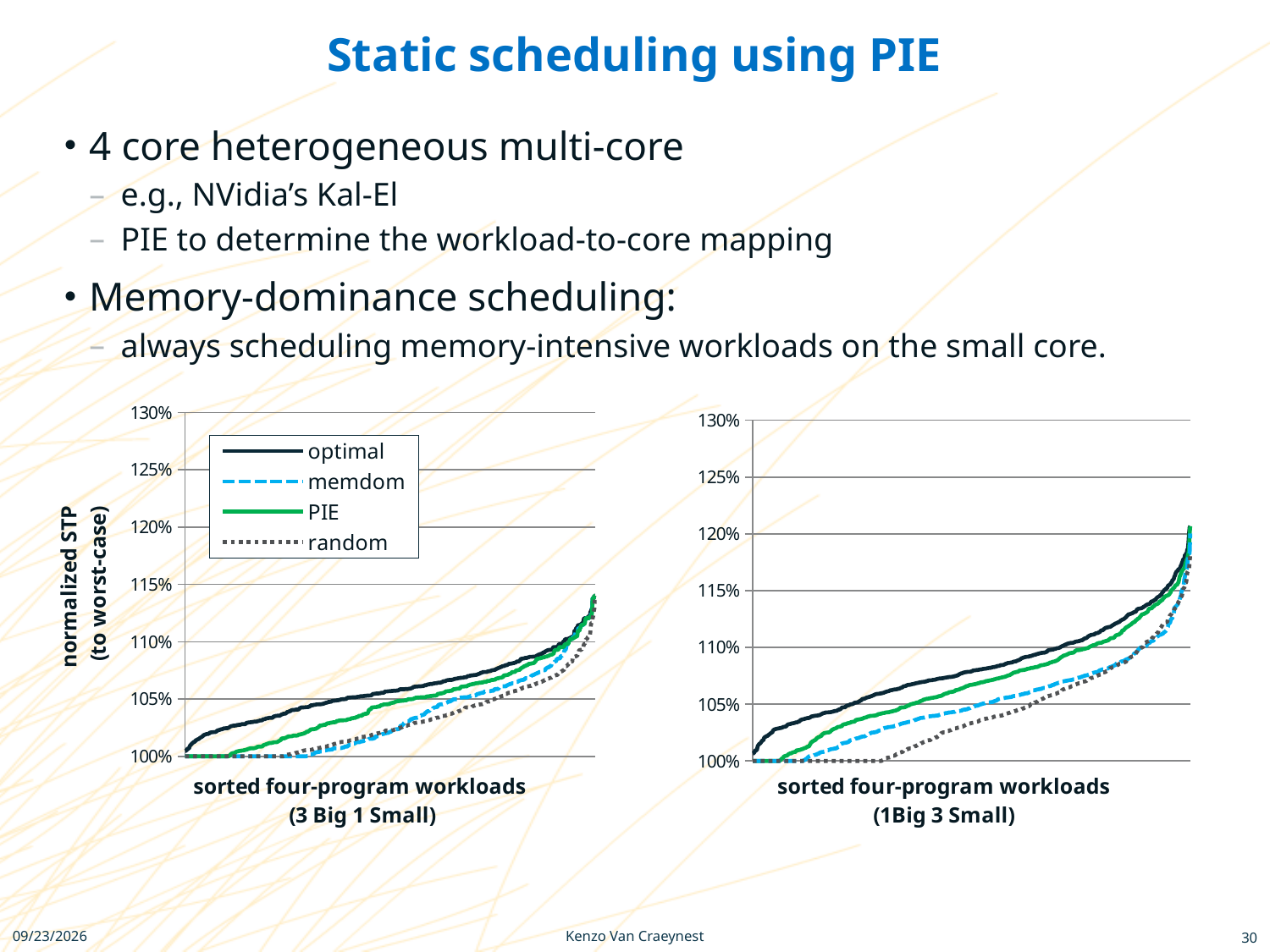
In the right chart (1Big 3 Small), is the highest value reached by the optimal line greater or less than 115%? greater In the right chart (1Big 3 Small), around the middle of the x axis, which is higher: the PIE line or the memdom line? PIE In the left chart (3 Big 1 Small), do the values of the lines rise or fall along the x axis? rise What are the series names listed in the legend of the left chart (3 Big 1 Small)? optimal, memdom, PIE, random What is the highest tick value shown on the y axis of the right chart (1Big 3 Small)? 130% In the left chart (3 Big 1 Small), is the highest value reached by the optimal line greater or less than 120%? less In the right chart (1Big 3 Small), do the values of the lines rise or fall along the x axis? rise How many series does the legend on the left chart (3 Big 1 Small) list? 4 What is the y-axis label on the left chart (3 Big 1 Small)? normalized STP (to worst-case) In the right chart (1Big 3 Small), which series lies highest across the middle of the x axis? optimal In the right chart (1Big 3 Small), which series lies lowest across the middle of the x axis? random What kind of chart is the left chart, labelled "sorted four-program workloads (3 Big 1 Small)"? line chart